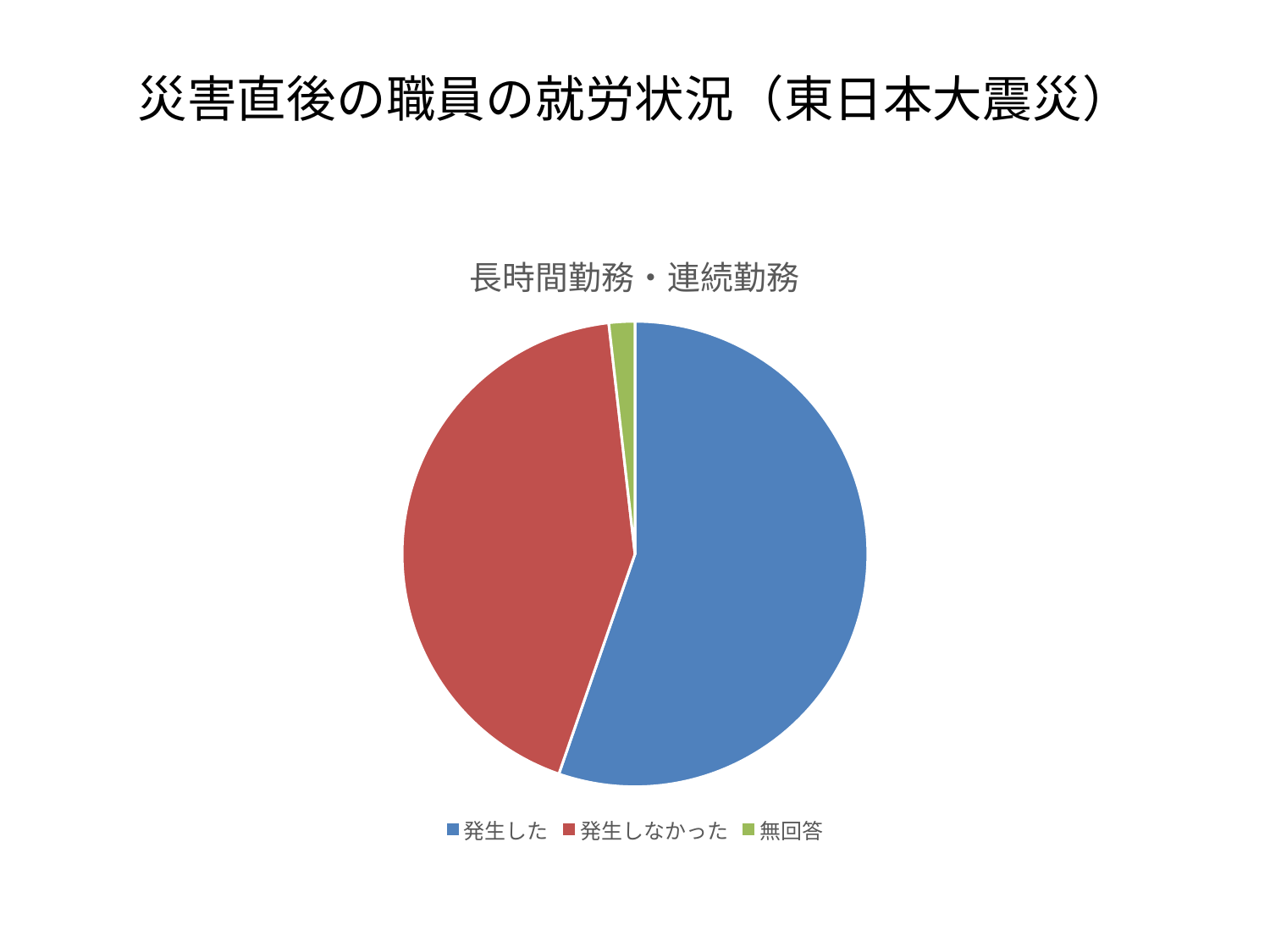
What is the title of the pie chart? 長時間勤務・連続勤務 What colour is the 無回答 slice in the pie chart? green Which category has the smallest slice in the pie chart? 無回答 How many entries does the legend of the pie chart list? 3 Which slice is larger, 発生しなかった or 無回答? 発生しなかった Which slice is larger, 発生した or 発生しなかった? 発生した What kind of chart is shown on the slide? pie chart How many slices does the pie chart have? 3 Which category has the largest slice in the pie chart? 発生した